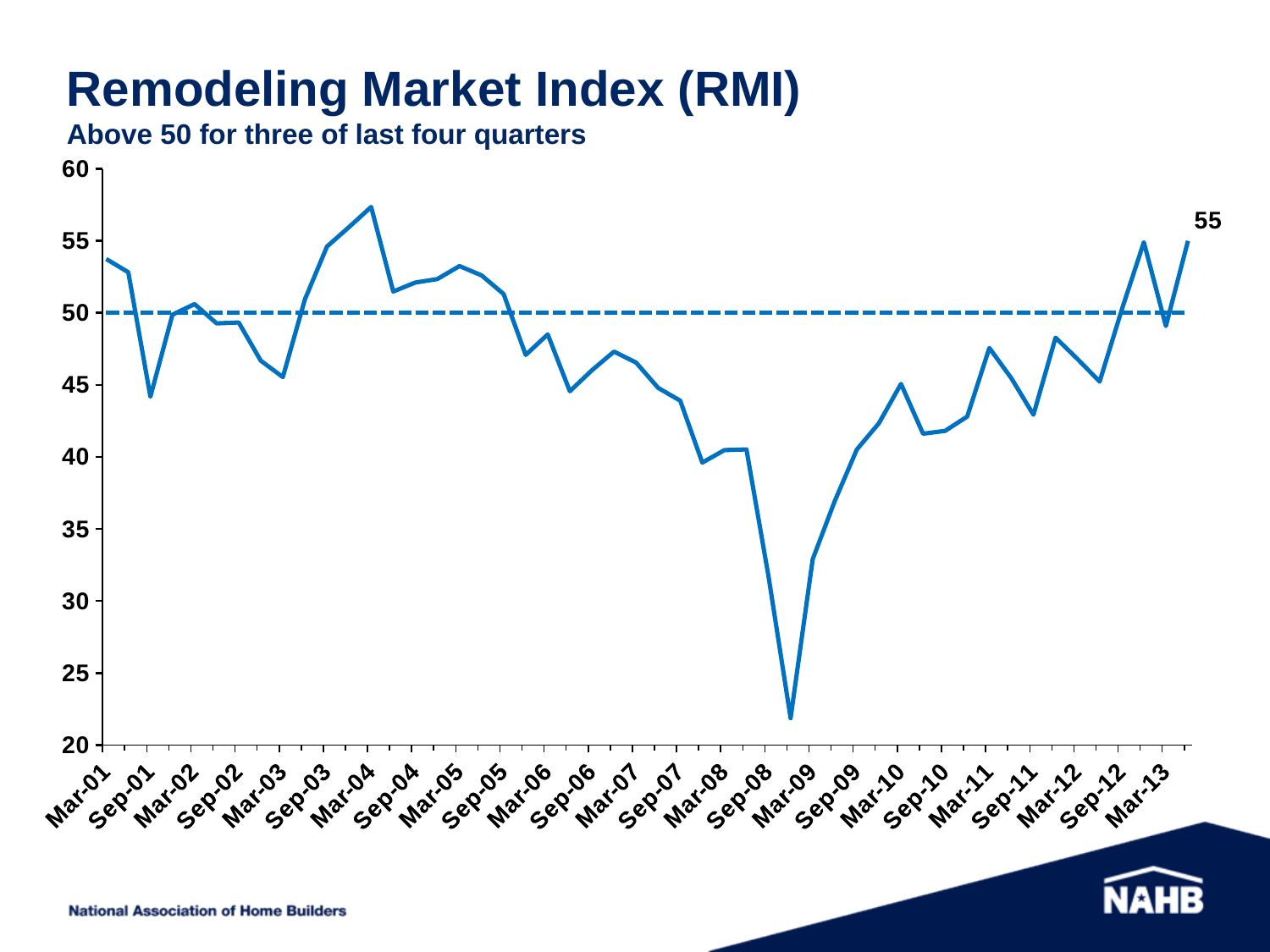
At what value is the horizontal dashed reference line drawn? 50 Is the value for Mar-04 greater or less than 55? greater Is the value for Sep-11 greater or less than 45? less Which is larger, the value for Mar-04 or the value for Mar-09? Mar-04 Is the value for Mar-13 greater or less than 50? less Which is larger, the value for Sep-12 or the value for Mar-12? Sep-12 Does the line rise or fall between Sep-08 and the trough near Mar-09? fall How many date labels are shown on the x axis? 25 What kind of chart is shown on the slide? line chart